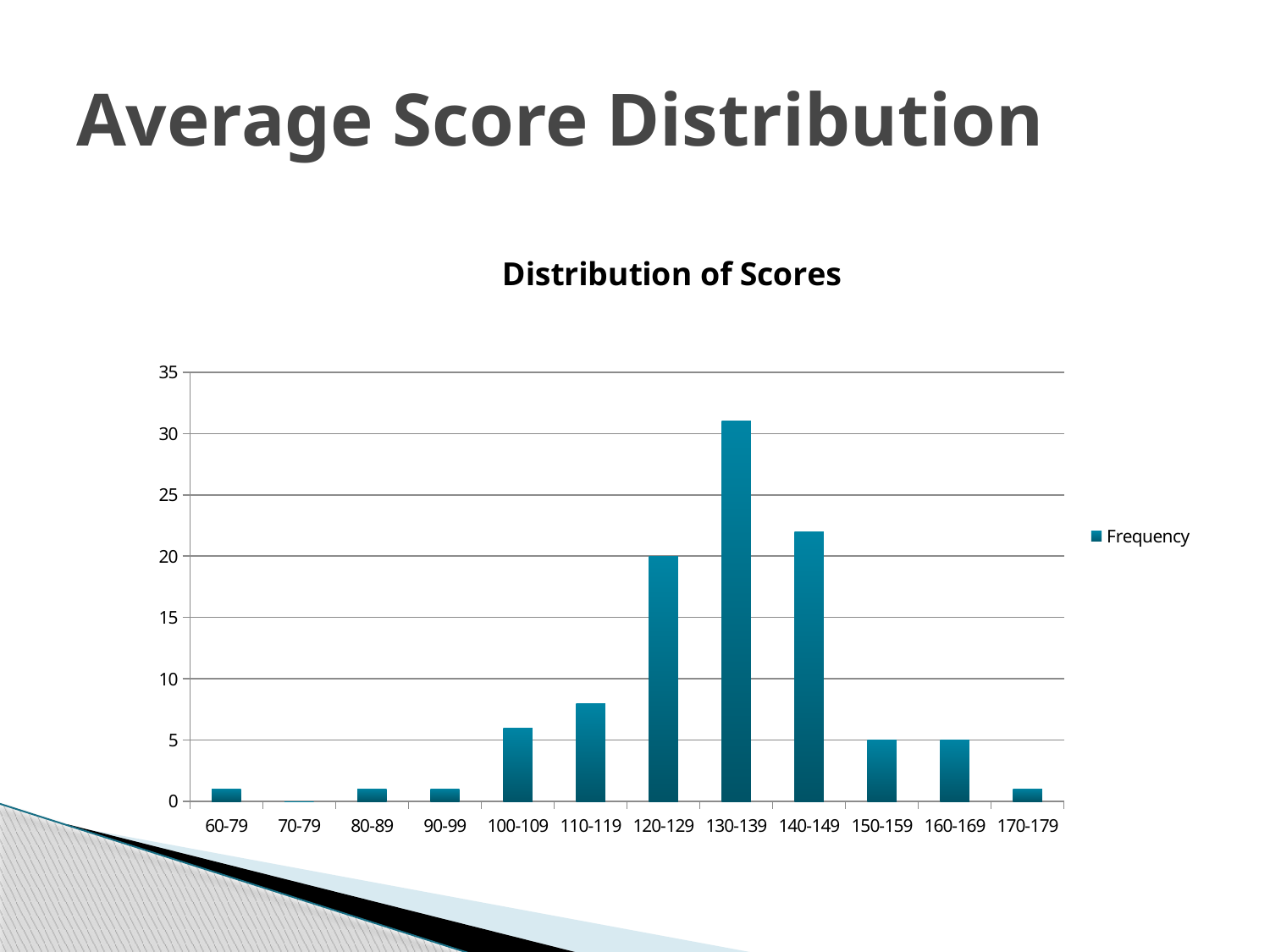
What is the frequency for the 150-159 score range? 5 Which has a higher frequency, 130-139 or 140-149? 130-139 What is the title of the chart? Distribution of Scores What is the frequency for the 120-129 score range? 20 Is the frequency for 130-139 greater or less than 30? greater Which score range has the lowest frequency? 70-79 What series name does the legend list? Frequency How many score ranges are shown on the x axis? 12 What type of chart is shown on the slide? bar chart Is the frequency for 140-149 greater or less than 25? less How many series does the legend list? 1 Which score range has the highest frequency? 130-139